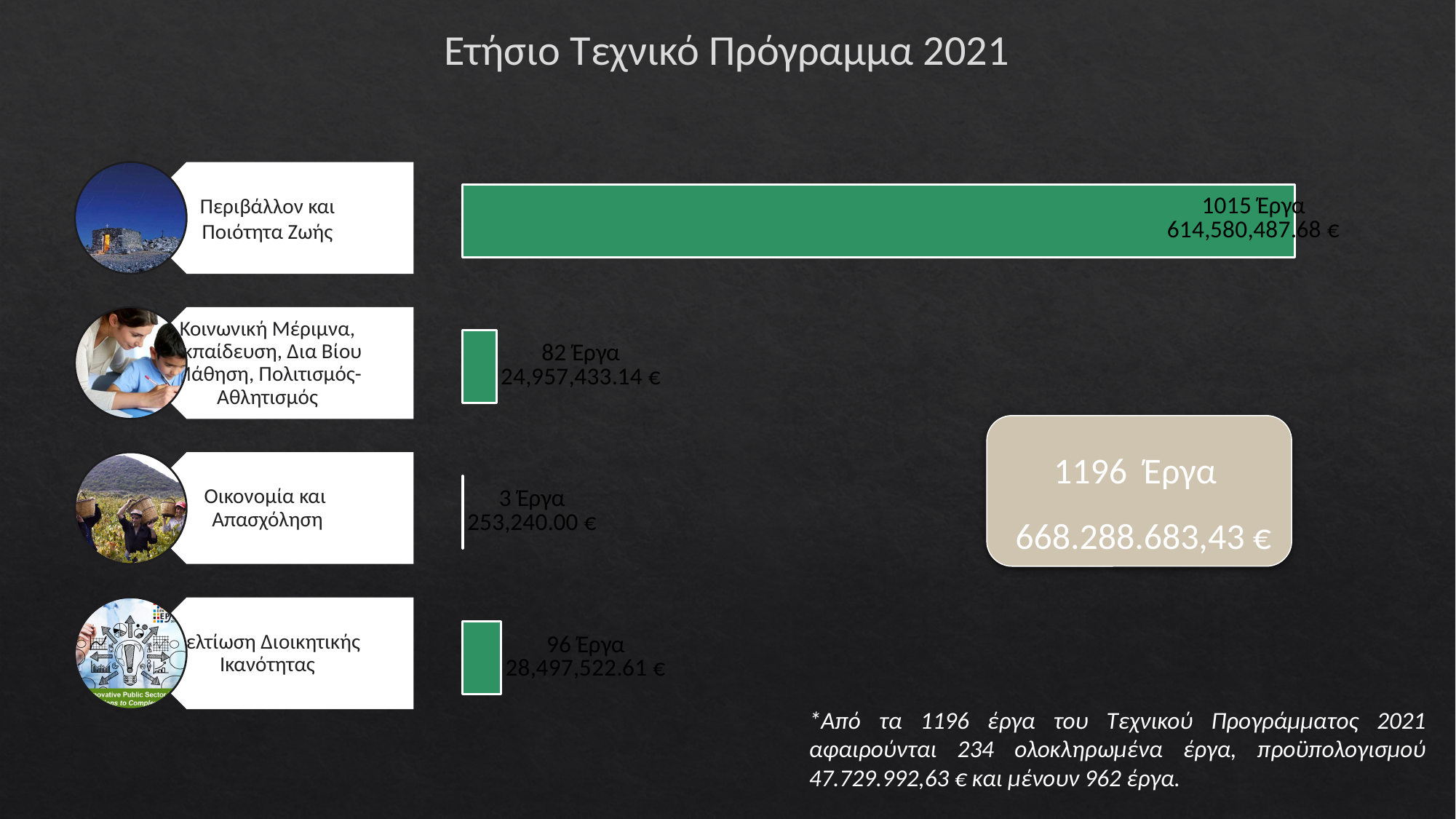
What is the budget amount shown for Οικονομία και Απασχόληση? 253,240.00 € What is the difference in the number of projects between Περιβάλλον και Ποιότητα Ζωής and Βελτίωση Διοικητικής Ικανότητας? 919 Which category has the lowest number of projects? Οικονομία και Απασχόληση How many projects (Έργα) are shown for Βελτίωση Διοικητικής Ικανότητας? 96 Έργα How many categories does the bar chart show? 4 What is the title of the slide containing the chart? Ετήσιο Τεχνικό Πρόγραμμα 2021 What is the budget amount shown for Περιβάλλον και Ποιότητα Ζωής? 614,580,487.68 € What kind of chart is shown on the slide? bar chart Which has more projects, Βελτίωση Διοικητικής Ικανότητας or the Κοινωνική Μέριμνα category? Βελτίωση Διοικητικής Ικανότητας What is the budget amount shown for the Κοινωνική Μέριμνα category? 24,957,433.14 € How many projects (Έργα) are shown for Περιβάλλον και Ποιότητα Ζωής? 1015 Έργα Which category has the highest number of projects? Περιβάλλον και Ποιότητα Ζωής